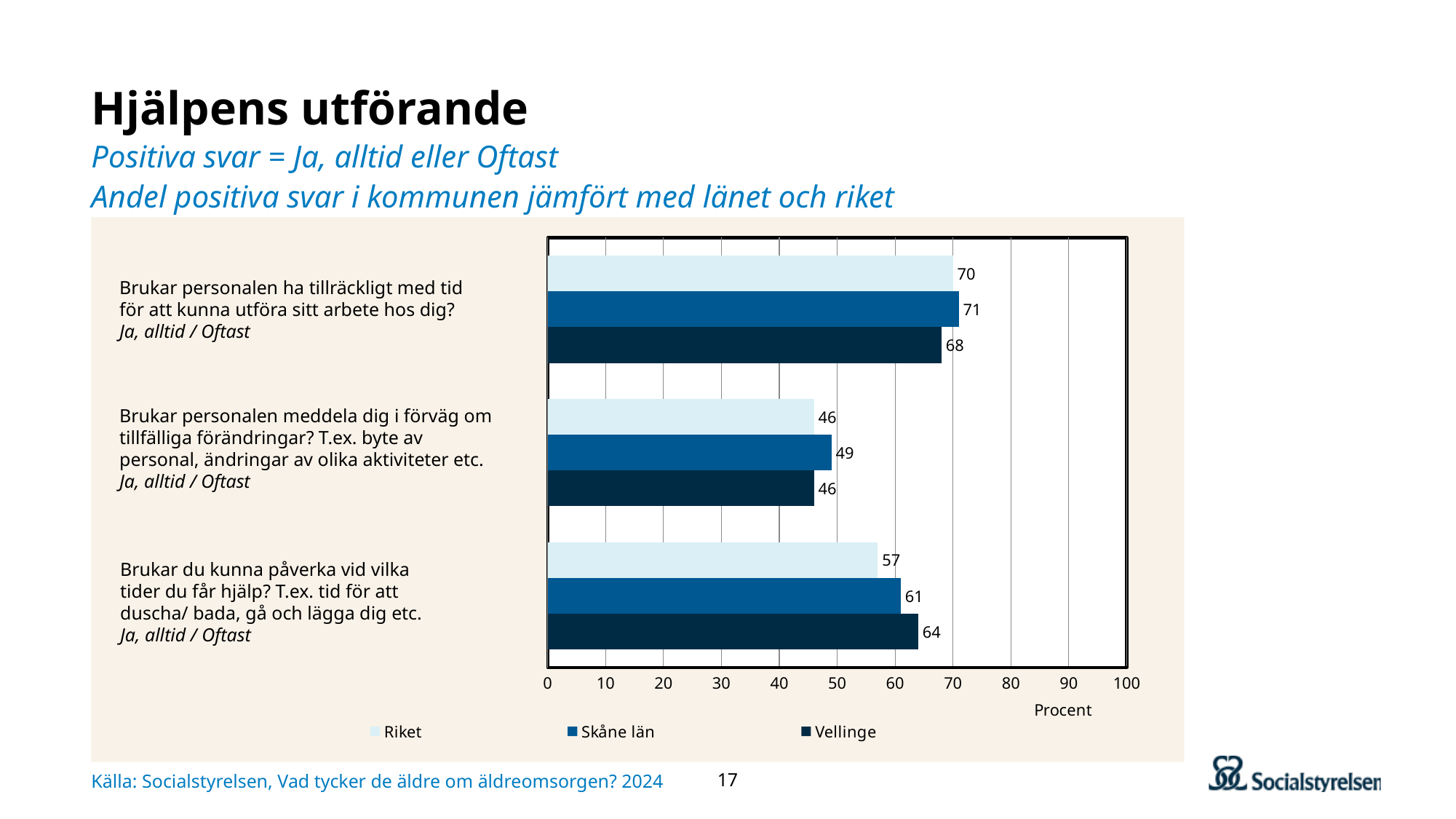
What kind of chart is shown on the slide? Bar chart What is the difference between Vellinge and Riket on the question "Brukar du kunna påverka vid vilka tider du får hjälp?"? 7 Which series has the lowest value on the question "Brukar personalen ha tillräckligt med tid för att kunna utföra sitt arbete hos dig?"? Vellinge How many question categories are shown on the chart? 3 Is the value for Riket on the question "Brukar personalen meddela dig i förväg om tillfälliga förändringar?" greater or less than 50? less Which series has the highest value on the question "Brukar du kunna påverka vid vilka tider du får hjälp?"? Vellinge What is the value for Skåne län on the question "Brukar personalen meddela dig i förväg om tillfälliga förändringar?"? 49 Which is larger on the question "Brukar personalen meddela dig i förväg om tillfälliga förändringar?": Skåne län or Vellinge? Skåne län What is the value for Riket on the question "Brukar du kunna påverka vid vilka tider du får hjälp?"? 57 How many series does the legend list? 3 What is the value for Vellinge on the question "Brukar personalen ha tillräckligt med tid för att kunna utföra sitt arbete hos dig?"? 68 What is the label of the x axis? Procent